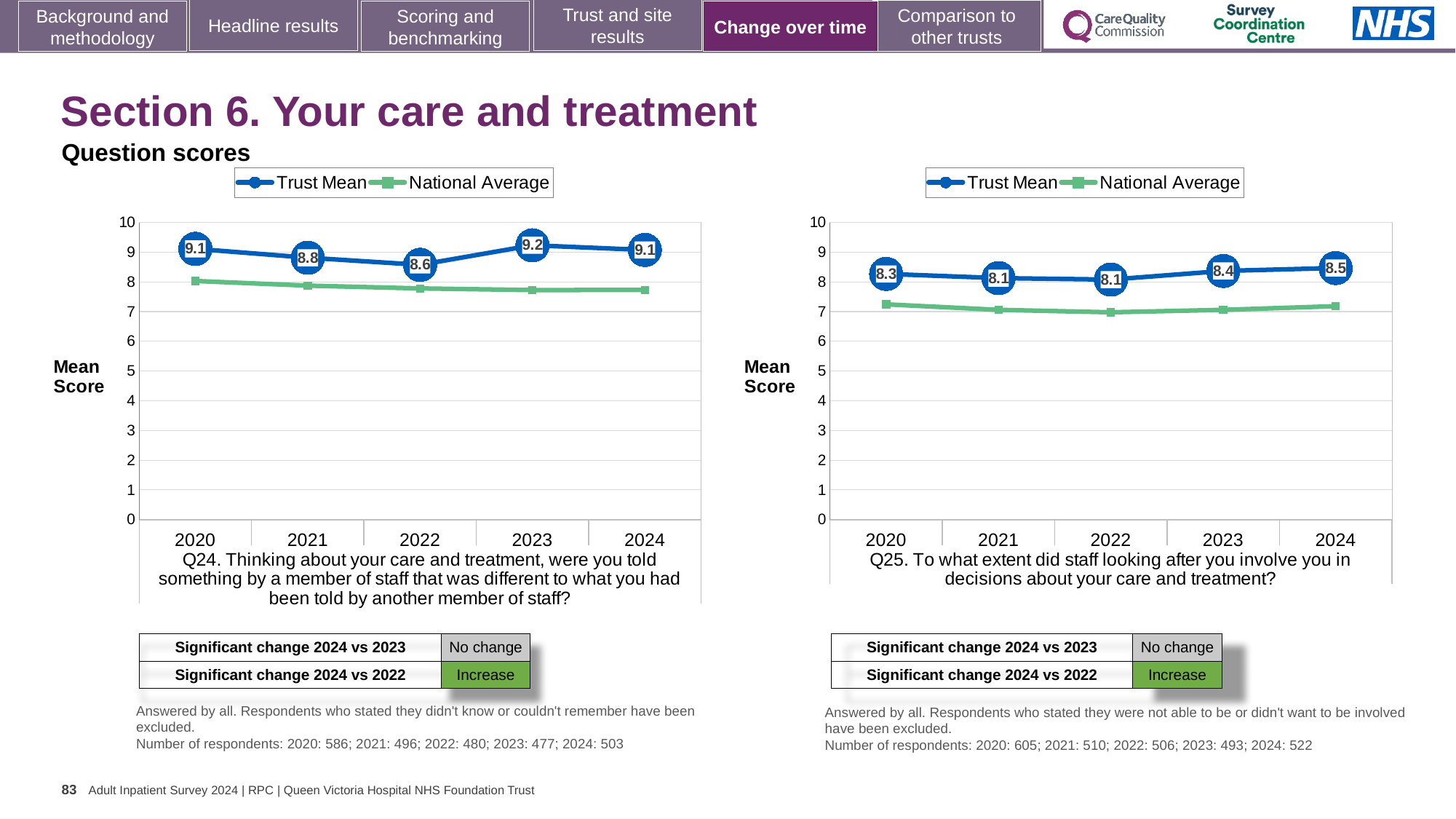
In the Q24 chart (left), what is the Trust Mean score for 2023? 9.2 How many series does the legend of the Q24 chart (left) list? 2 In the Q25 chart (right), what is the Trust Mean score for 2024? 8.5 What type of chart is used for Q24 (left)? Line chart In the Q24 chart (left), which year has the lowest Trust Mean score? 2022 In the Q25 chart (right), is the National Average value for 2020 greater or less than 7? greater In the Q24 chart (left), is the National Average value for 2024 greater or less than 8? less In the Q25 chart (right), does the Trust Mean score rise or fall from 2022 to 2024? Rise In the Q25 chart (right), which is larger, the Trust Mean score for 2020 or for 2021? 2020 How many years are plotted on the x axis of the Q25 chart (right)? 5 In the Q24 chart (left), what is the difference between the Trust Mean scores for 2023 and 2022? 0.6 In the Q25 chart (right), which year has the highest Trust Mean score? 2024